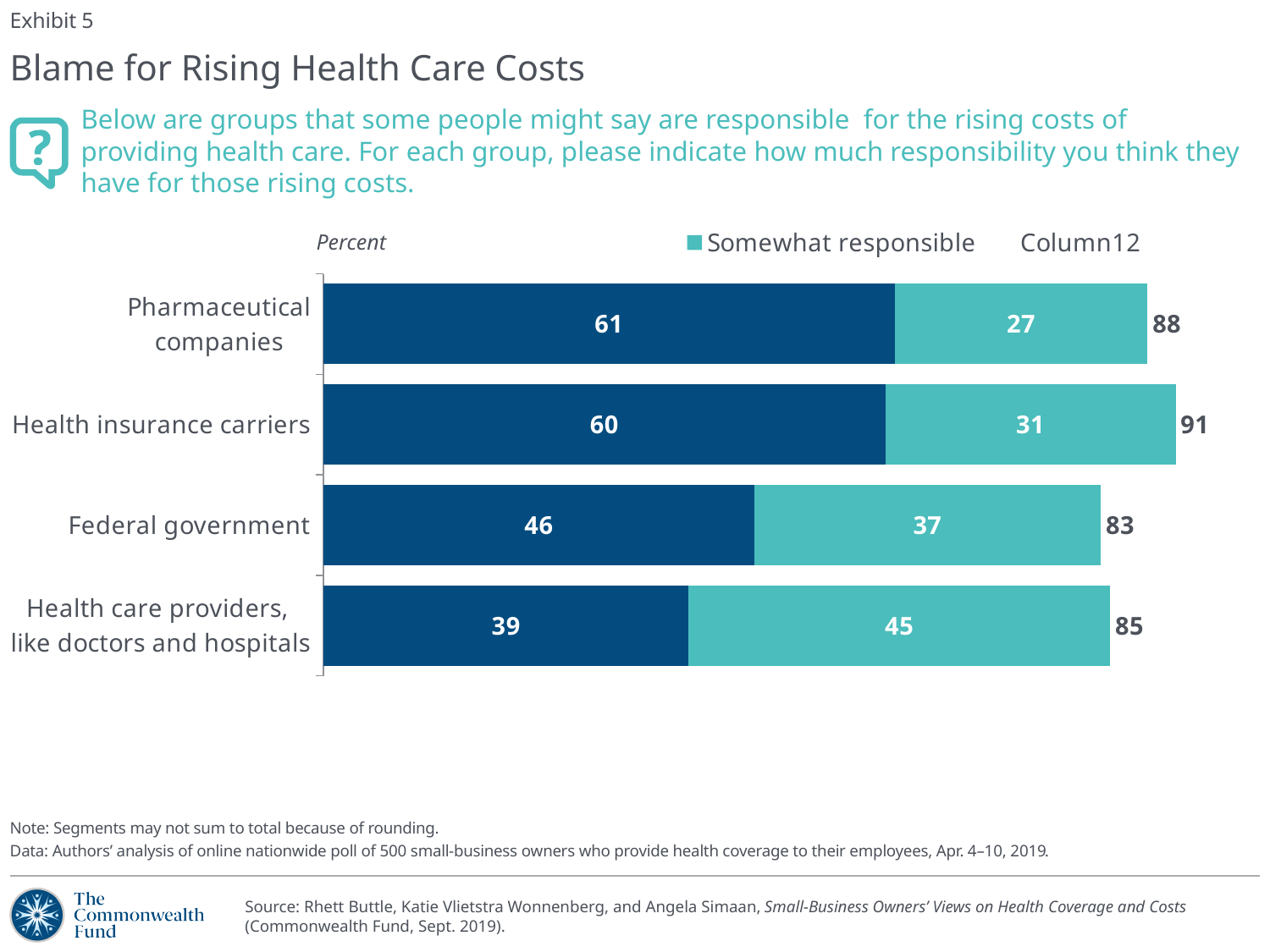
What are the two entries listed in the chart legend? Somewhat responsible and Column12 What is the dark blue segment value for Pharmaceutical companies? 61 Which has a larger 'Somewhat responsible' value: Federal government or Health insurance carriers? Federal government What is the 'Somewhat responsible' value for Federal government? 37 What kind of chart is shown on the slide? Stacked bar chart What is the title of the chart on the slide? Blame for Rising Health Care Costs How many groups are shown in the chart? 4 Which group has the lowest total printed at the end of its bar? Federal government What is the difference between the 'Somewhat responsible' values for Health care providers, like doctors and hospitals and Pharmaceutical companies? 18 Which group has the highest total printed at the end of its bar? Health insurance carriers What total is printed at the end of the bar for Health insurance carriers? 91 Which group has the largest 'Somewhat responsible' value? Health care providers, like doctors and hospitals